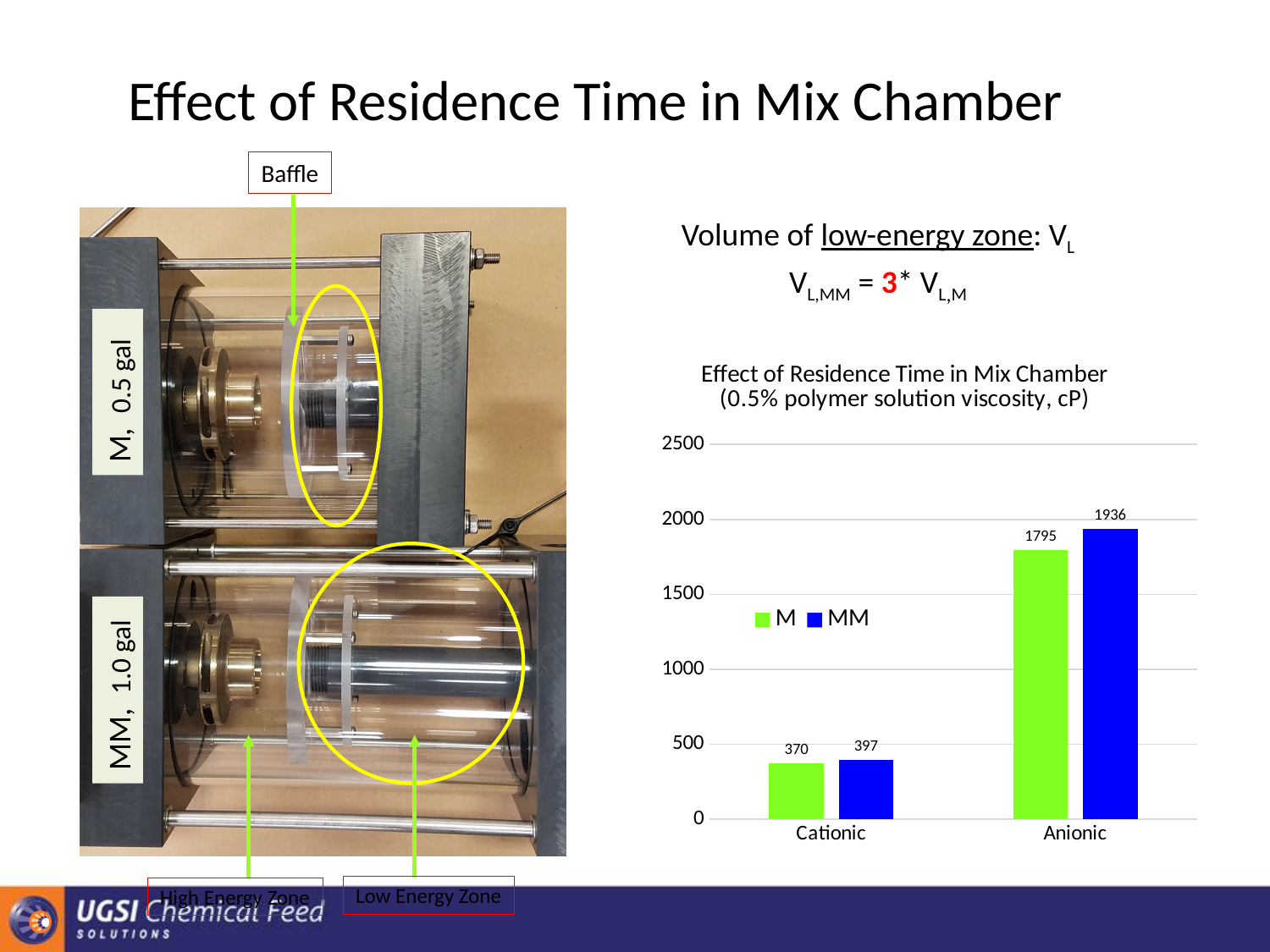
What type of chart is shown on the slide? bar chart Which category has the highest value for the MM series? Anionic Is the value for M in the Anionic category greater or less than 2000? less What is the value for M in the Anionic category? 1795 How many series does the chart legend list? 2 What is the value for MM in the Cationic category? 397 Which is larger in the Cationic category, M or MM? MM What is the value for M in the Cationic category? 370 How many categories are shown on the x axis of the chart? 2 Which category has the lowest value for the M series? Cationic What is the difference between the MM and M values in the Anionic category? 141 What is the value for MM in the Anionic category? 1936